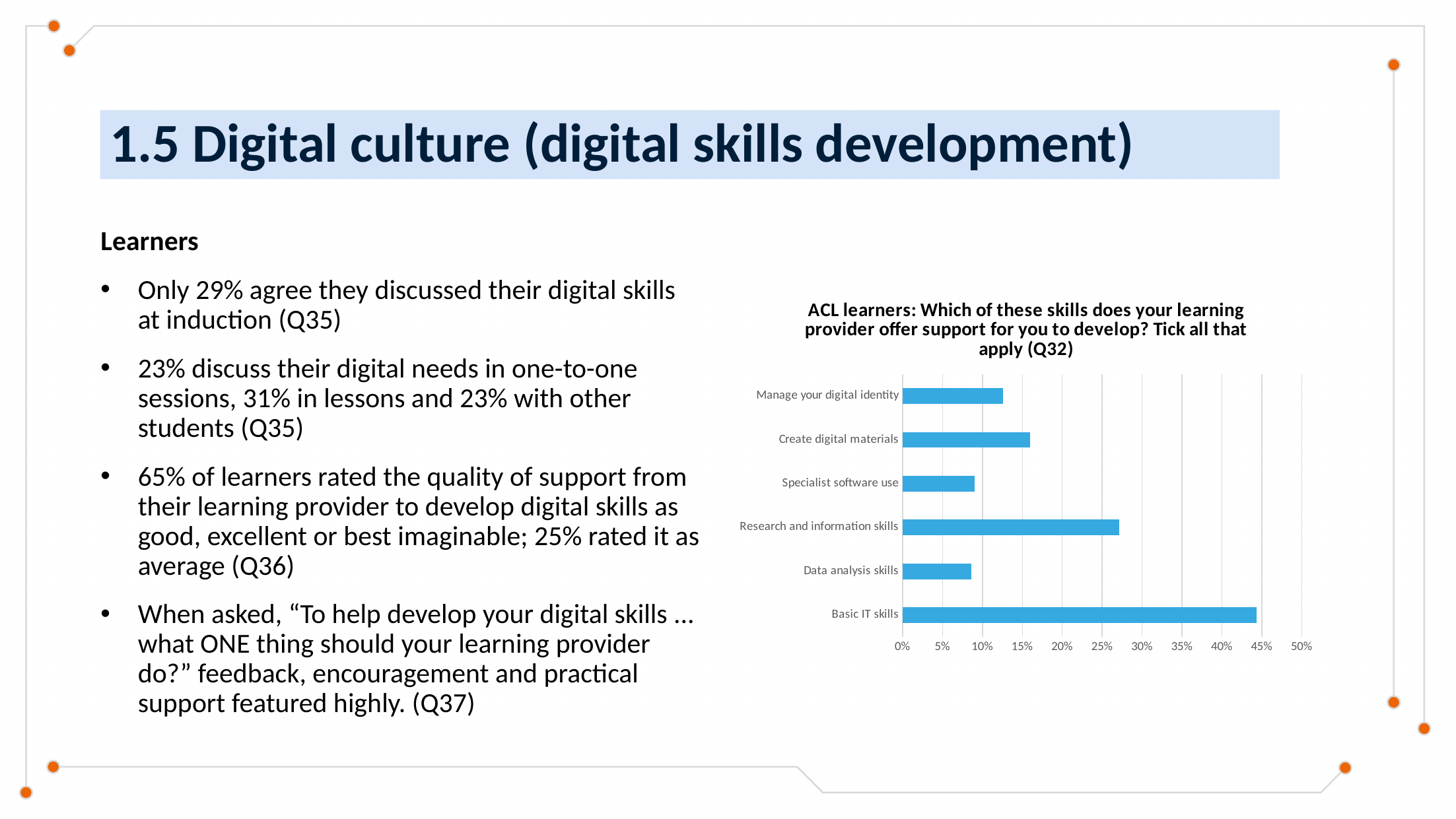
Which is larger: the value for Research and information skills or the value for Create digital materials? Research and information skills Is the value for Create digital materials greater or less than 20%? less Is the value for Data analysis skills greater or less than 10%? less Is the value for Basic IT skills greater or less than 40%? greater How many skill categories are plotted in the chart? 6 What kind of chart is shown on the slide? bar chart Which question number is referenced in the chart title? Q32 Which is larger: the value for Basic IT skills or the value for Research and information skills? Basic IT skills Which skill has the highest percentage in the chart? Basic IT skills